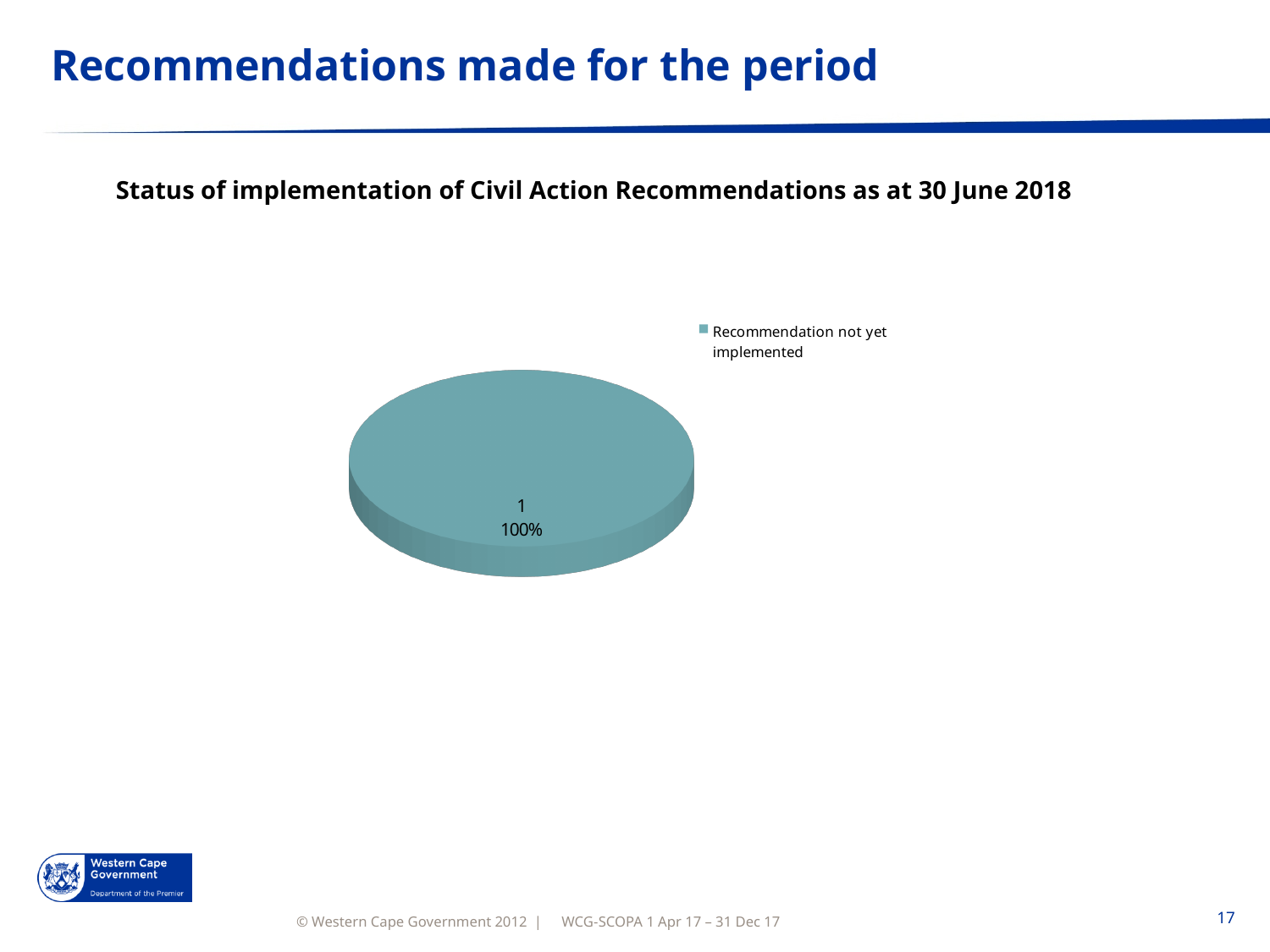
What is the legend entry for the only slice in the pie chart? Recommendation not yet implemented Is the value for 'Recommendation not yet implemented' greater or less than 50%? greater How many slices does the pie chart have? 1 What is the value shown for 'Recommendation not yet implemented'? 1 What is the title of the chart? Status of implementation of Civil Action Recommendations as at 30 June 2018 How many entries does the legend list? 1 What share of the pie does 'Recommendation not yet implemented' represent? 100% What kind of chart is shown on the slide? pie chart